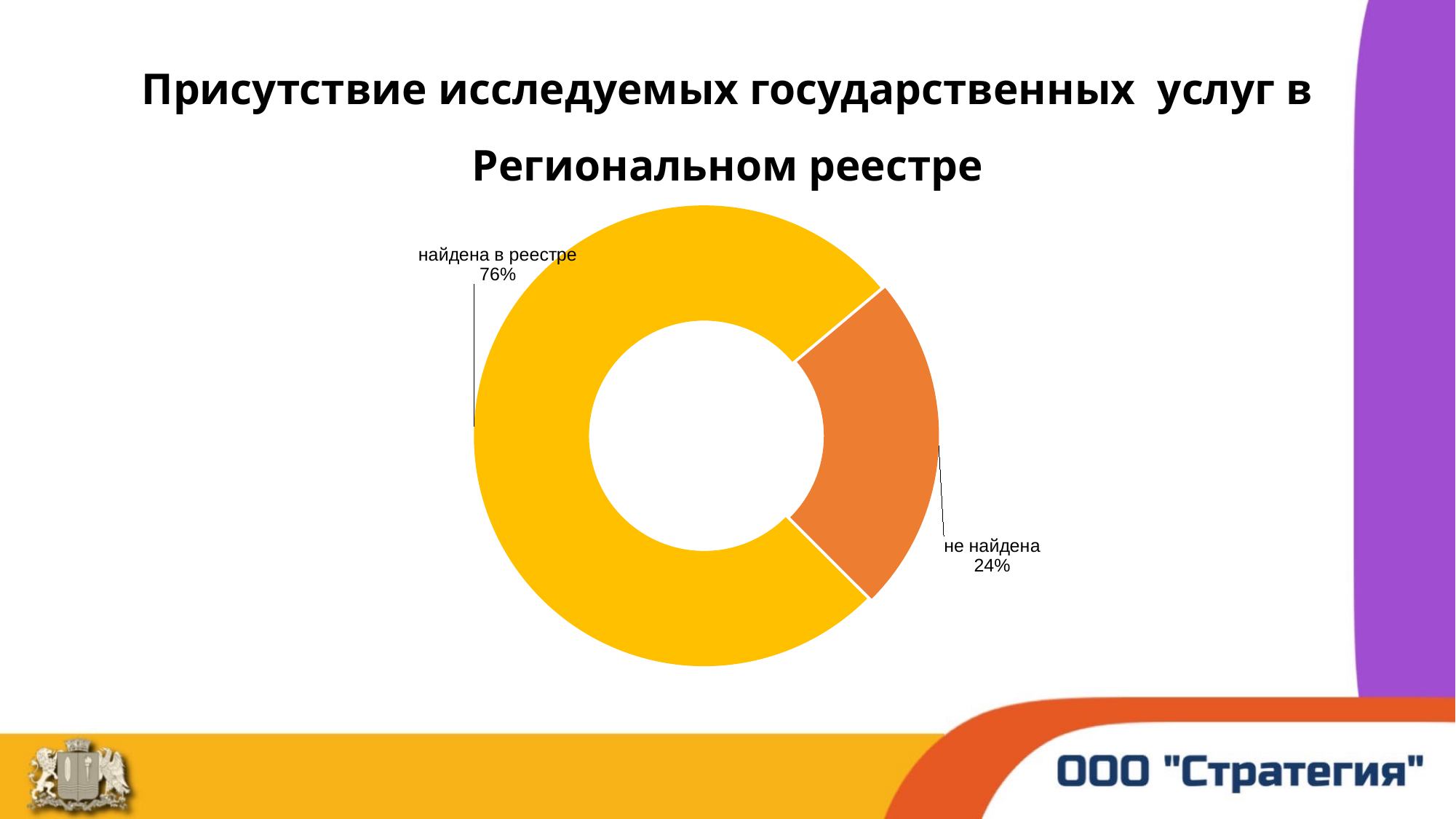
What kind of chart is shown on the slide? Doughnut (pie) chart Which is larger: the share for "найдена в реестре" or for "не найдена"? найдена в реестре Which slice is the smallest? не найдена Which slice is the largest? найдена в реестре What share of the chart is labelled "найдена в реестре"? 76% What is the title of the slide above the chart? Присутствие исследуемых государственных услуг в Региональном реестре What share of the chart is labelled "не найдена"? 24% How many slices does the chart have? 2 What colour is the "не найдена" slice? Orange Is the share for "не найдена" greater or less than 50%? less What is the difference in percentage points between "найдена в реестре" and "не найдена"? 52